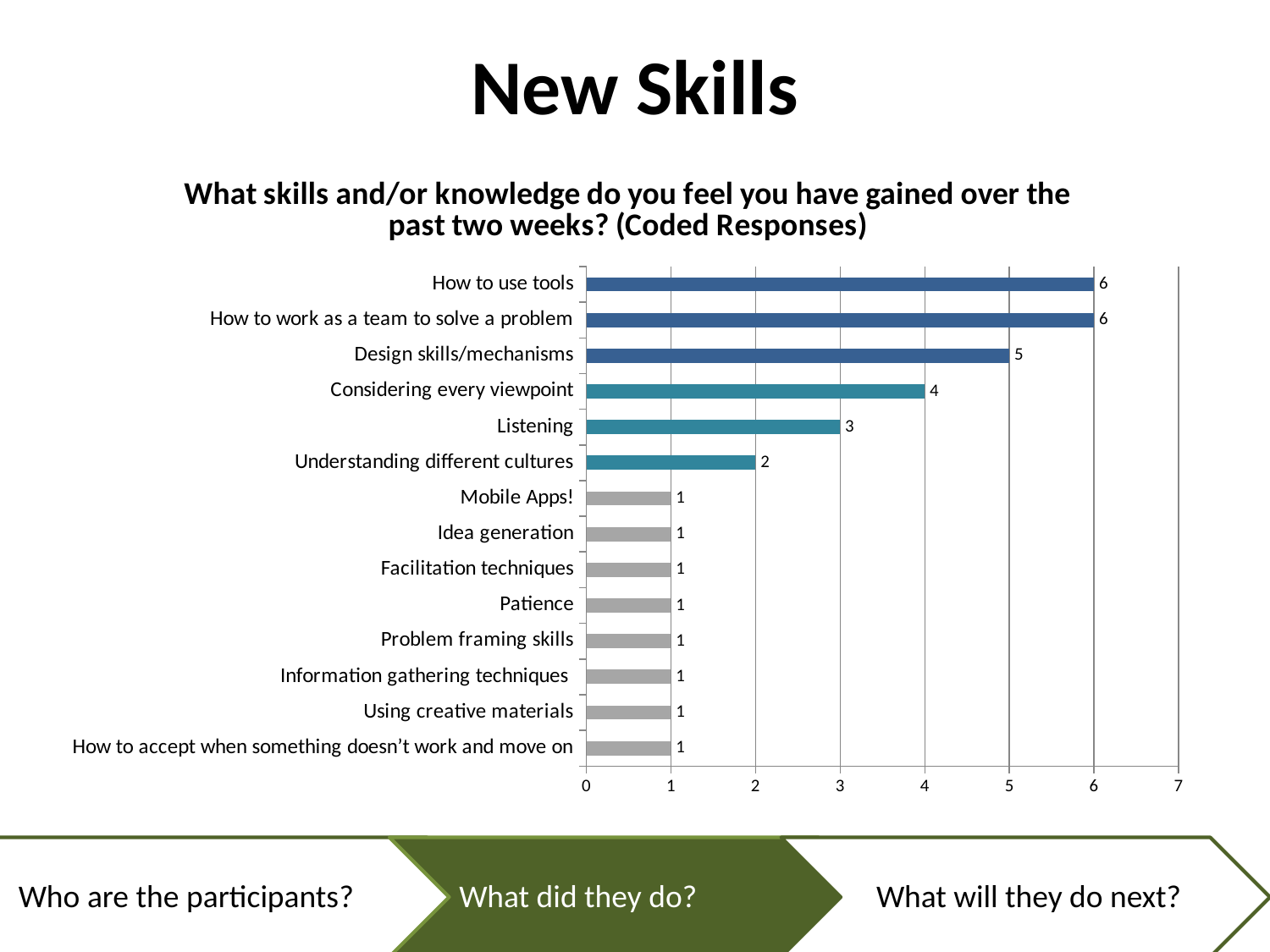
What is the value for "Considering every viewpoint"? 4 Which categories have the highest value? How to use tools; How to work as a team to solve a problem What is the value for "Listening"? 3 How many categories are shown in the chart? 14 What is the value for "Design skills/mechanisms"? 5 What is the difference between the values for "How to use tools" and "Listening"? 3 How many categories have a value of 1? 8 What is the value for "Understanding different cultures"? 2 What is the title of the chart? What skills and/or knowledge do you feel you have gained over the past two weeks? (Coded Responses) Is the value for "How to work as a team to solve a problem" greater or less than 4? greater What kind of chart is shown on the slide? bar chart Which is larger, the value for "Design skills/mechanisms" or the value for "Considering every viewpoint"? Design skills/mechanisms